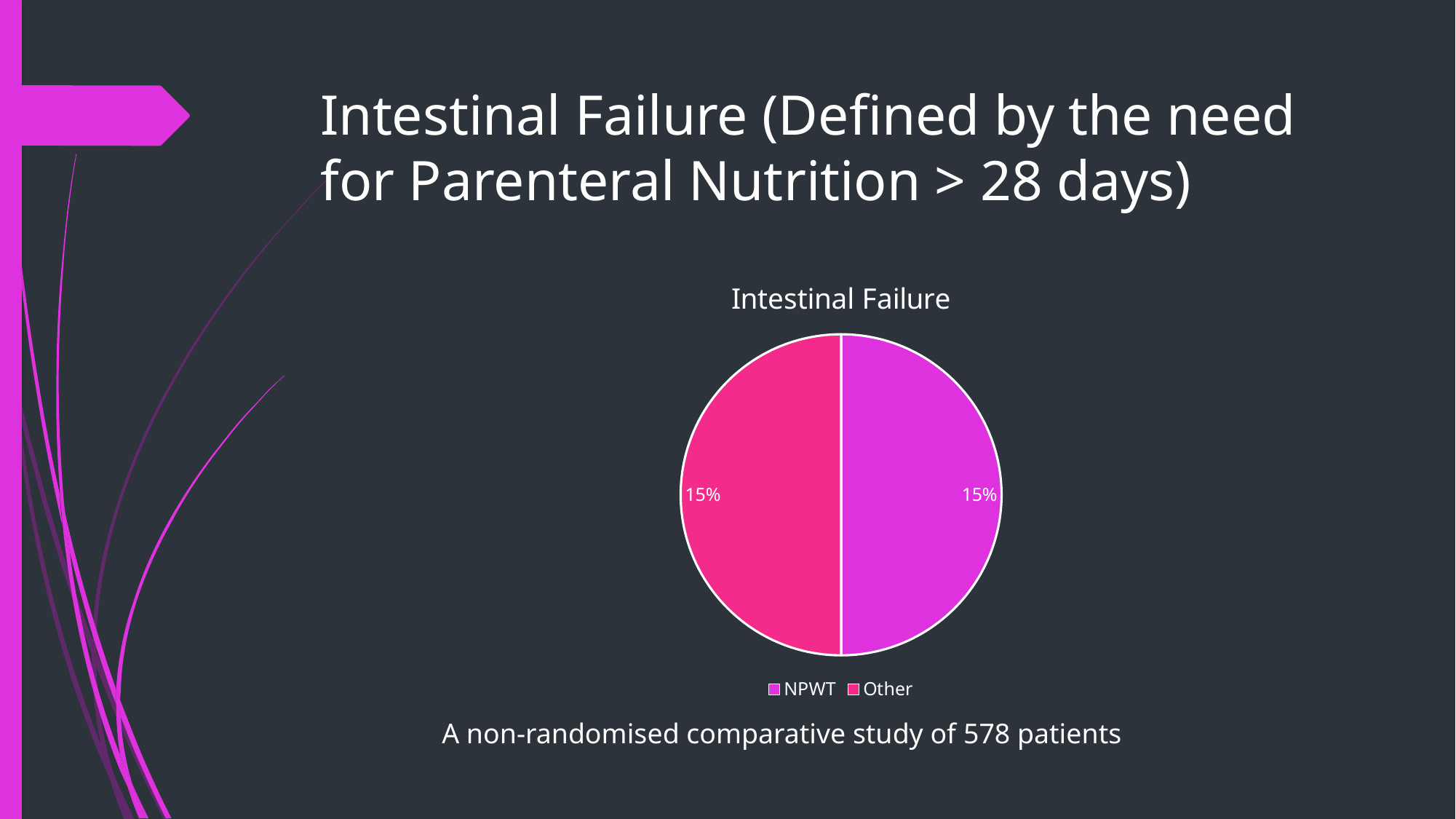
What kind of chart is shown on the slide? pie chart What share of the pie is labelled for NPWT? 15% What is the difference between the NPWT value and the Other value? 0% How many slices does the pie chart have? 2 Which legend entries are listed below the pie chart? NPWT and Other What is the title of the chart? Intestinal Failure What percentage is shown for the Other slice? 15% How many entries does the legend list? 2 What percentage is shown for the NPWT slice? 15%